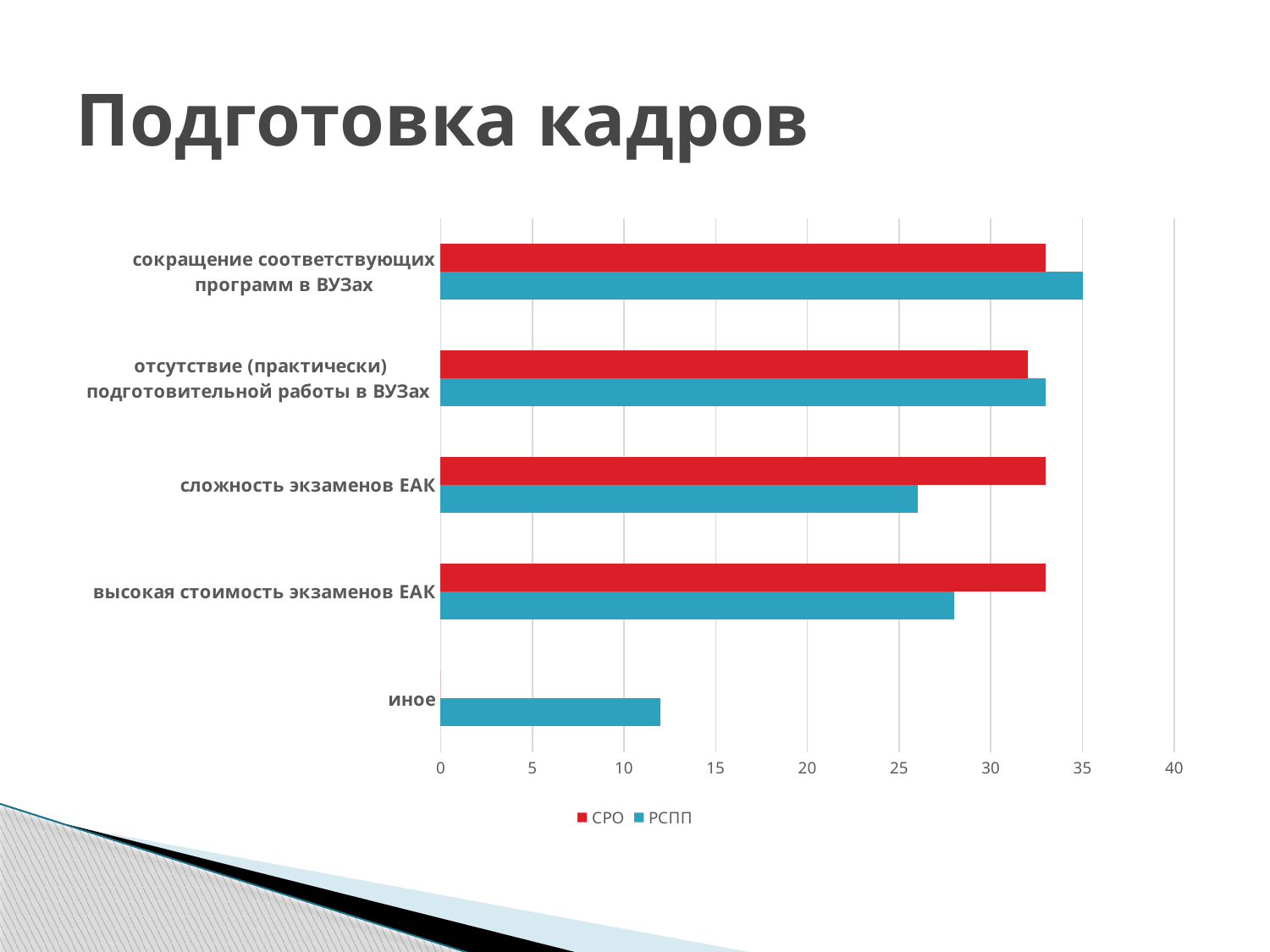
For сложность экзаменов ЕАК, which series has the larger value, СРО or РСПП? СРО Is the РСПП value for иное greater or less than 15? less How many series does the legend list? 2 Which category has the lowest value for СРО? иное For высокая стоимость экзаменов ЕАК, which series has the larger value, СРО or РСПП? СРО Which series are listed in the legend? СРО and РСПП Is the СРО value for сокращение соответствующих программ в ВУЗах greater or less than 30? greater For иное, which series has the larger value, СРО or РСПП? РСПП Which category has the highest value for РСПП? сокращение соответствующих программ в ВУЗах How many categories are shown on the chart? 5 Which category has the lowest value for РСПП? иное What kind of chart is shown on the slide? bar chart